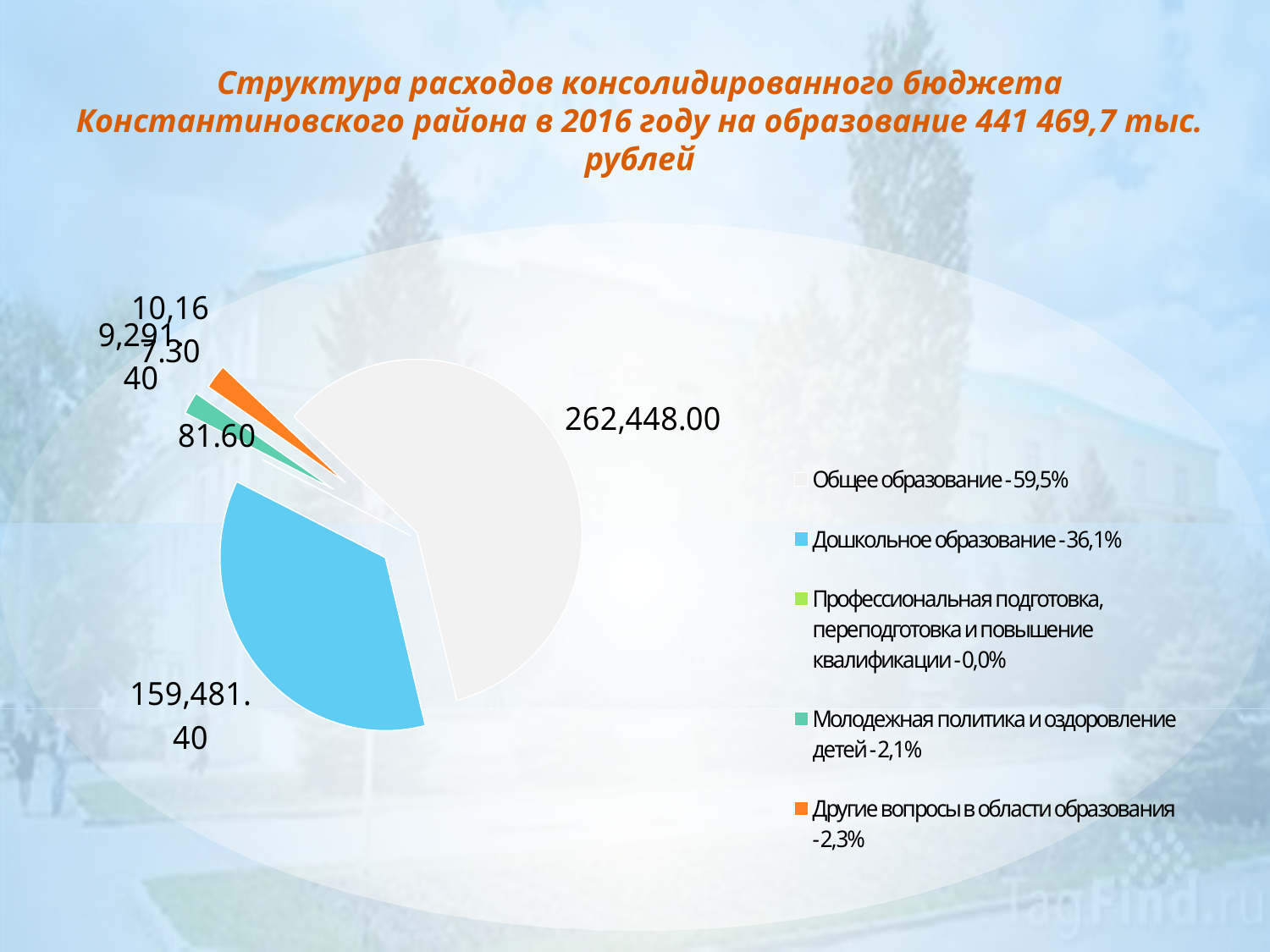
What is the difference between the values for Общее образование and Дошкольное образование? 102,966.60 What share of the pie does Общее образование have according to the legend? 59,5% What share of the pie does Молодежная политика и оздоровление детей have according to the legend? 2,1% How many categories does the legend list? 5 Which category has the largest slice of the pie? Общее образование What share of the pie does Дошкольное образование have according to the legend? 36,1% What is the value shown for Общее образование? 262,448.00 What is the value shown for Дошкольное образование? 159,481.40 Which is larger, the value for Общее образование or the value for Дошкольное образование? Общее образование What kind of chart is shown on the slide? pie chart Which category has the smallest share according to the legend? Профессиональная подготовка, переподготовка и повышение квалификации